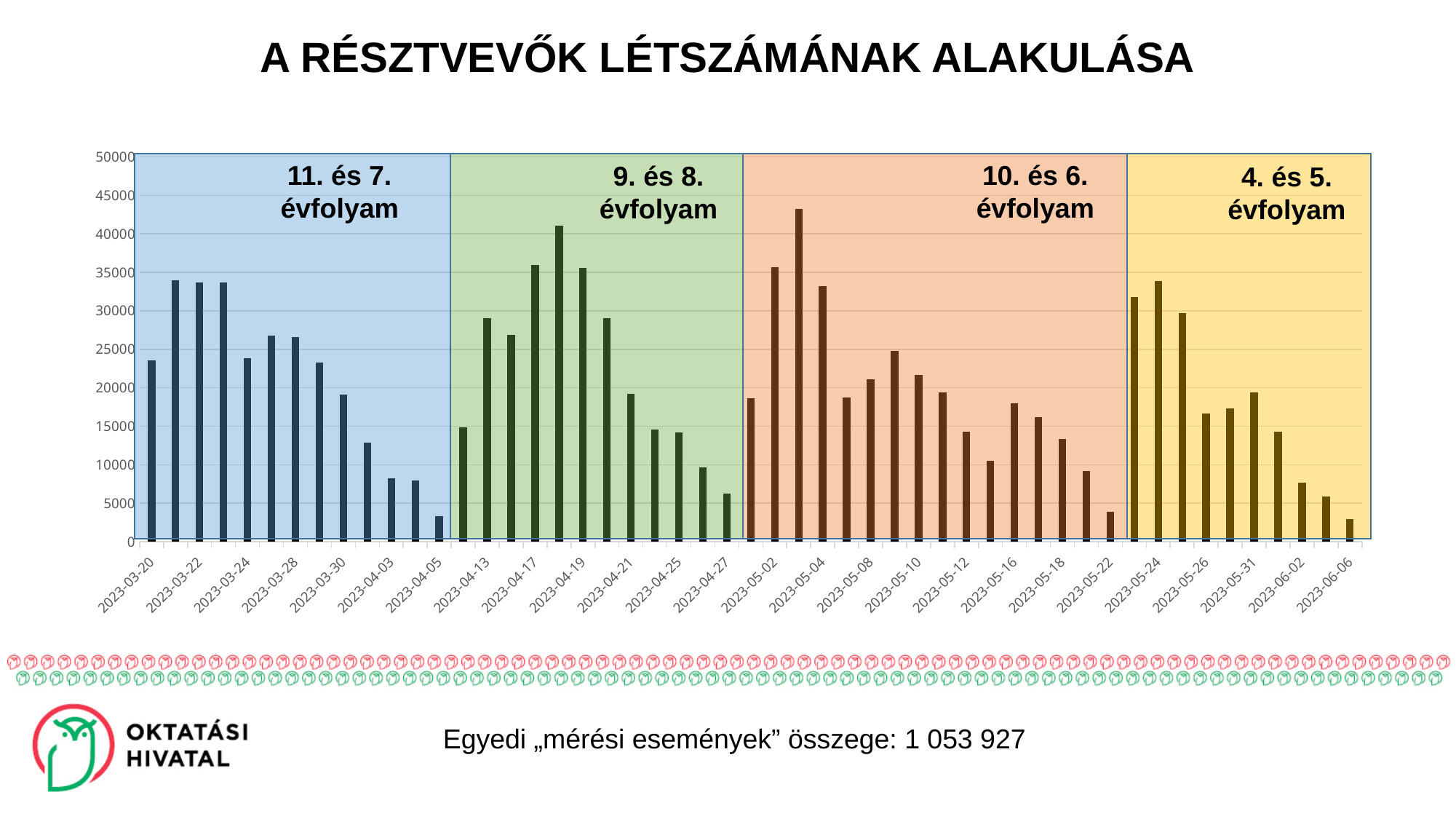
Is the value for 2023-04-05 greater or less than 5000? less Is the value for 2023-05-22 greater or less than 5000? less Is the value for 2023-05-04 greater or less than 40000? less What kind of chart is shown on the slide? bar chart Which is larger, the value for 2023-03-20 or the value for 2023-03-22? 2023-03-22 Which is larger, the value for 2023-05-02 or the value for 2023-05-04? 2023-05-02 What is the title of the chart? A RÉSZTVEVŐK LÉTSZÁMÁNAK ALAKULÁSA How many shaded grade-group regions does the chart divide the bars into? 4 Which grade group is labelled in the yellow shaded region on the right of the chart? 4. és 5. évfolyam